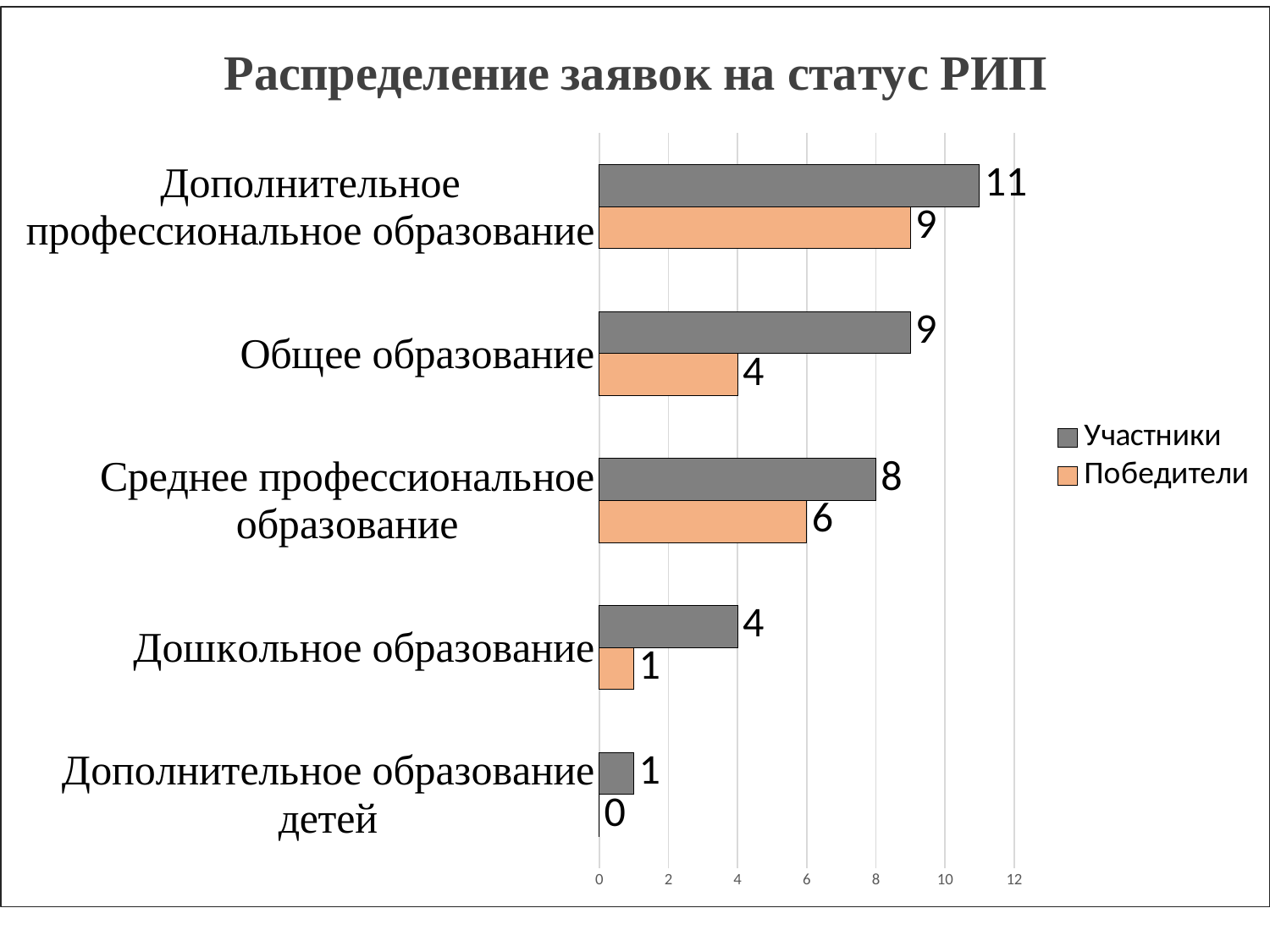
What is the value for Победители in the category Общее образование? 4 What is the title of the chart? Распределение заявок на статус РИП What is the value for Участники in the category Дополнительное профессиональное образование? 11 What is the value for Победители in the category Дополнительное образование детей? 0 What is the difference between Участники and Победители in the category Общее образование? 5 What kind of chart is shown on the slide? bar chart How many categories are shown on the chart? 5 Which is larger: Победители for Среднее профессиональное образование or Победители for Общее образование? Среднее профессиональное образование Which category has the lowest value for Победители? Дополнительное образование детей What is the value for Победители in the category Дошкольное образование? 1 How many series does the legend list? 2 Which category has the highest value for Участники? Дополнительное профессиональное образование